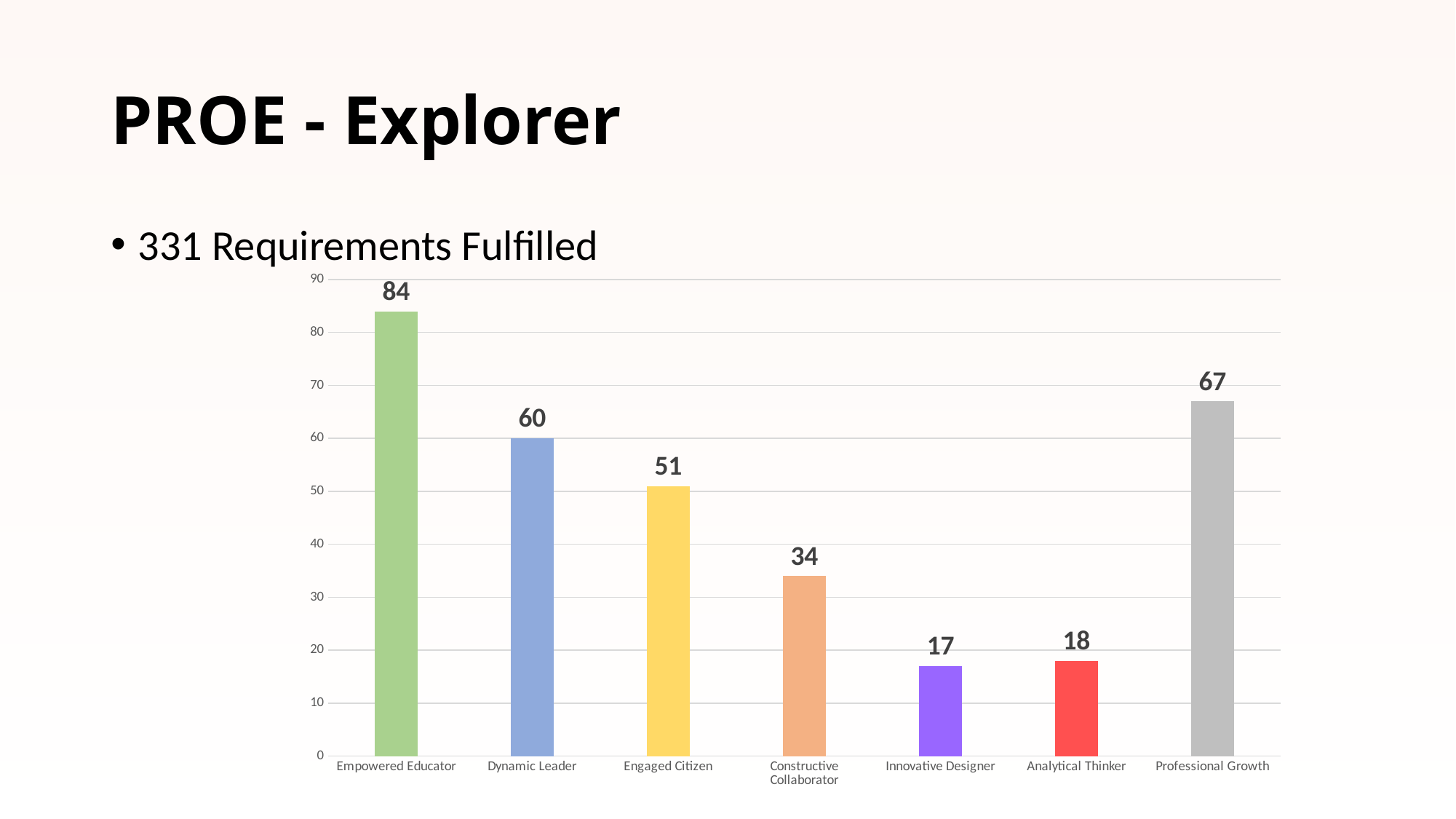
Is the value for Dynamic Leader greater or less than 50? greater What colour is the bar for Innovative Designer? purple How many categories are shown on the x axis? 7 What is the difference between the values for Empowered Educator and Dynamic Leader? 24 What is the value for Constructive Collaborator? 34 What is the value for Empowered Educator? 84 Which is larger, the value for Engaged Citizen or the value for Professional Growth? Professional Growth What is the value for Analytical Thinker? 18 What is the value for Professional Growth? 67 Which category has the lowest value? Innovative Designer What kind of chart is shown on the slide? bar chart Which category has the highest value? Empowered Educator